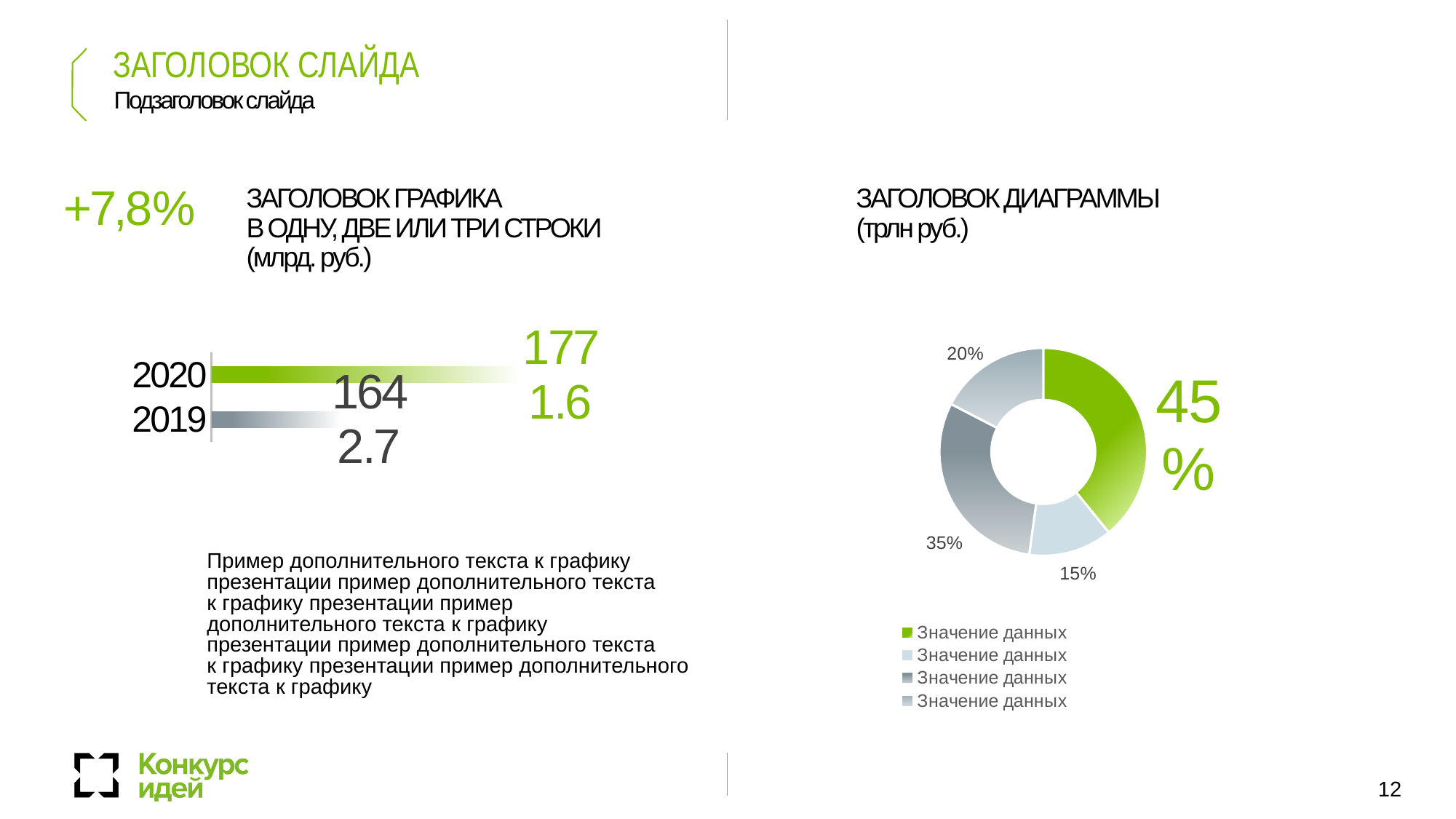
In the doughnut chart on the right, what value is shown for the green slice? 45% How many categories (years) does the bar chart on the left show? 2 In the doughnut chart on the right, which is larger, the 35% slice or the 20% slice? 35% What unit is given in the title of the bar chart on the left? млрд. руб. In the doughnut chart on the right, what is the value of the smallest slice? 15% In the doughnut chart on the right, what is the difference between the largest slice (45%) and the smallest slice (15%)? 30 percentage points In the bar chart on the left, which year has the longer bar, 2020 or 2019? 2020 How many entries does the legend of the doughnut chart on the right list? 4 What kind of chart is the chart on the right of the slide (ЗАГОЛОВОК ДИАГРАММЫ)? Doughnut (pie) chart In the doughnut chart on the right, what is the value of the largest slice? 45% What kind of chart is the chart on the left of the slide (ЗАГОЛОВОК ГРАФИКА)? Bar chart How many slices does the doughnut chart on the right have? 4